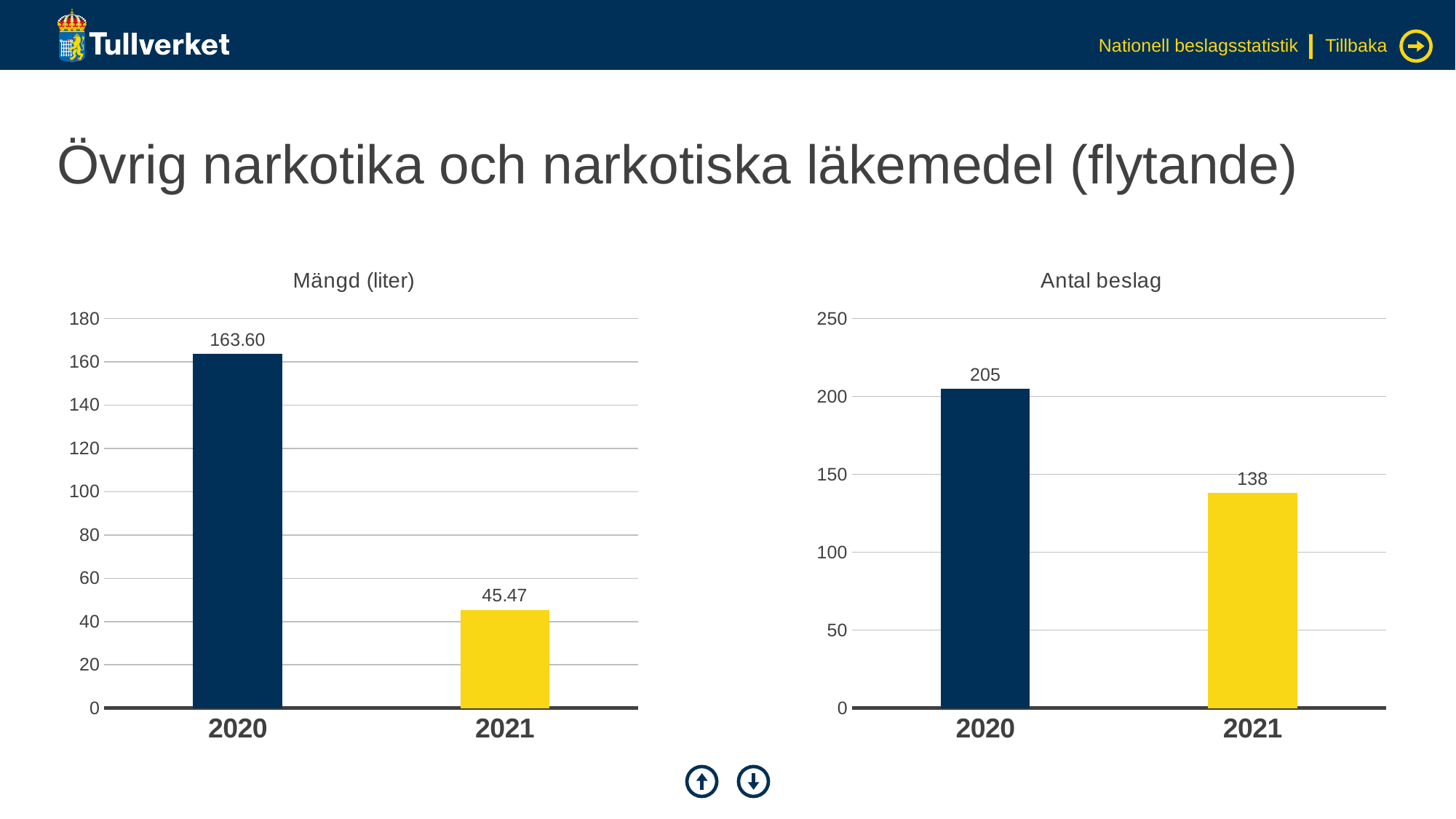
In the 'Mängd (liter)' chart, which year has the highest value? 2020 In the 'Mängd (liter)' chart, what is the value for 2020? 163.60 In the 'Mängd (liter)' chart, do the values rise or fall from 2020 to 2021? fall In the 'Antal beslag' chart, what is the difference between the 2020 and 2021 values? 67 In the 'Antal beslag' chart, what is the value for 2020? 205 In the 'Antal beslag' chart, which year has the lowest value? 2021 In the 'Mängd (liter)' chart, what is the value for 2021? 45.47 In the 'Mängd (liter)' chart, what is the difference between the 2020 and 2021 values? 118.13 What kind of chart is the 'Antal beslag' chart? bar chart In the 'Antal beslag' chart, is the value for 2021 greater or less than 150? less How many categories are shown on the x axis of the 'Mängd (liter)' chart? 2 In the 'Antal beslag' chart, what is the value for 2021? 138